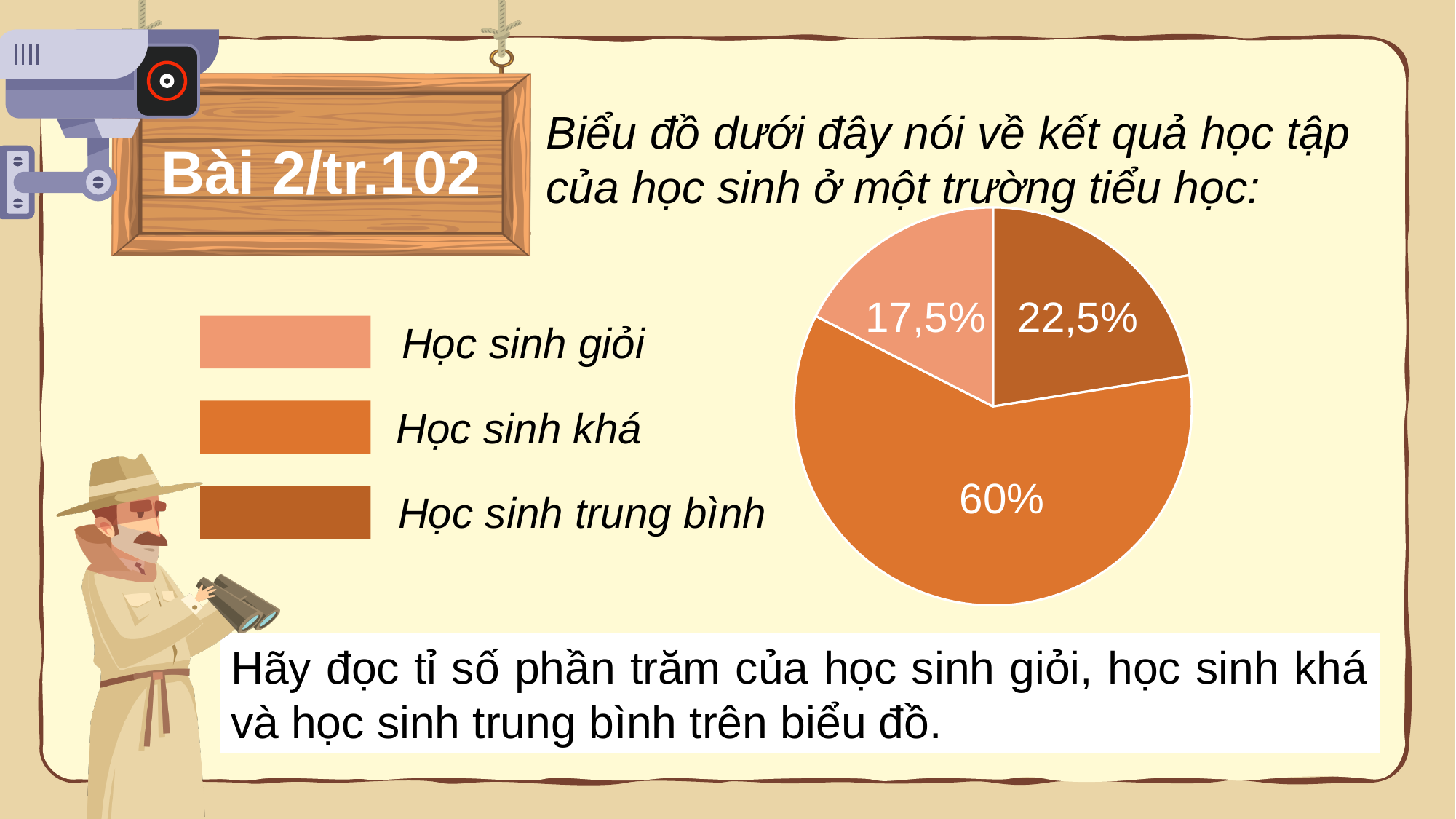
What kind of chart is shown on the slide? pie chart How many entries does the legend list? 3 Which legend entry is shown with the lightest colour? Học sinh giỏi What percentage of the pie chart is for Học sinh giỏi? 17,5% What percentage of the pie chart is for Học sinh trung bình? 22,5% What is the difference between the percentages for Học sinh trung bình and Học sinh giỏi? 5% What is the difference between the percentages for Học sinh khá and Học sinh trung bình? 37,5% What percentage of the pie chart is for Học sinh khá? 60% Which is larger, the slice for Học sinh giỏi or the slice for Học sinh trung bình? Học sinh trung bình How many slices does the pie chart have? 3 Which category has the smallest slice of the pie chart? Học sinh giỏi Which category has the largest slice of the pie chart? Học sinh khá